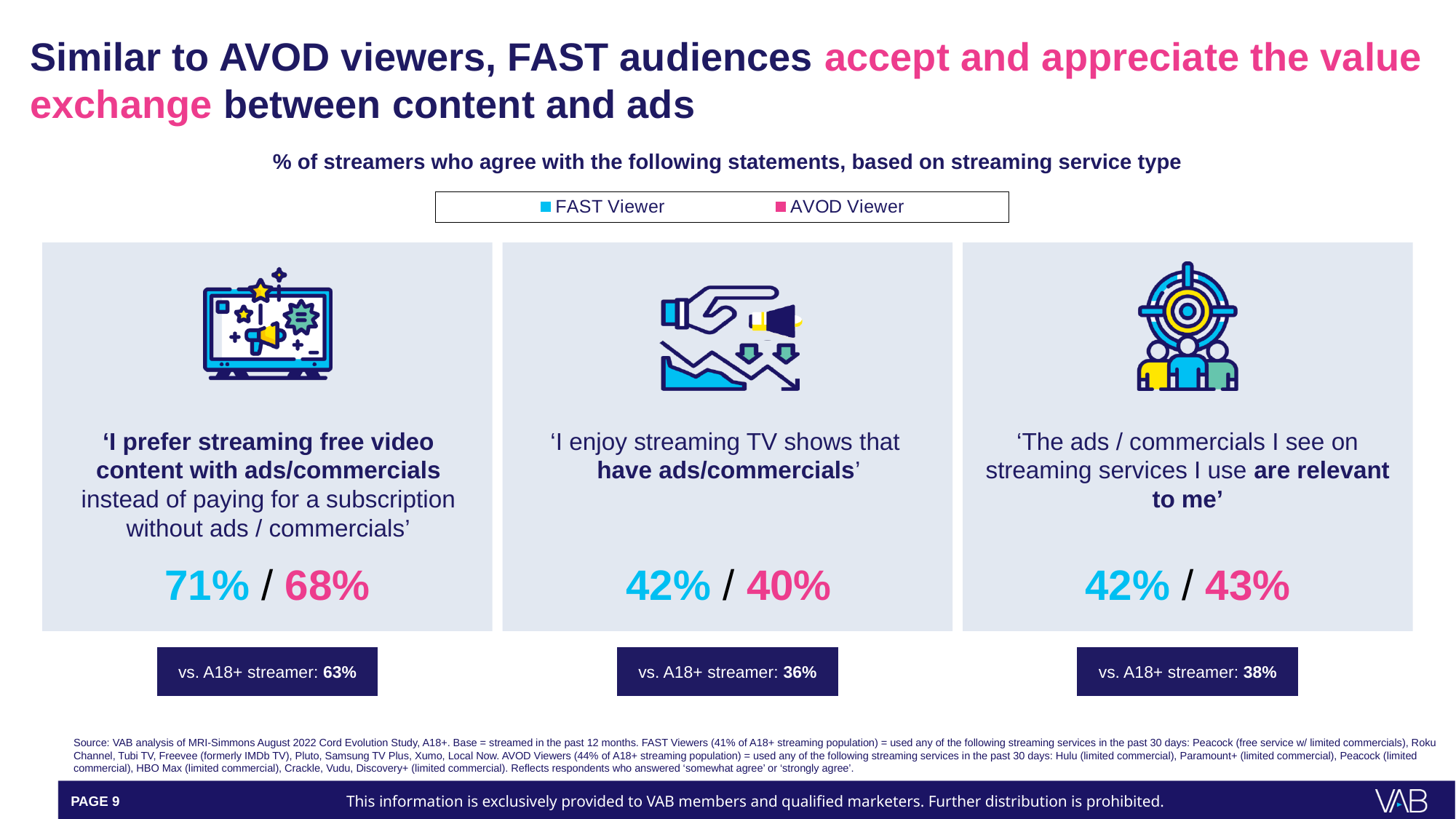
Which statement has the highest agreement among FAST Viewers? 'I prefer streaming free video content with ads/commercials instead of paying for a subscription without ads / commercials' How many viewer groups does the legend list? 2 For 'The ads / commercials I see on streaming services I use are relevant to me', which group has the higher agreement, FAST Viewers or AVOD Viewers? AVOD Viewers For 'I enjoy streaming TV shows that have ads/commercials', which group has the higher agreement, FAST Viewers or AVOD Viewers? FAST Viewers How many statements are shown on the slide? 3 What percentage of AVOD Viewers agree with 'I prefer streaming free video content with ads/commercials instead of paying for a subscription without ads / commercials'? 68% What is the A18+ streamer comparison value for 'I enjoy streaming TV shows that have ads/commercials'? 36% What percentage of FAST Viewers agree with 'I prefer streaming free video content with ads/commercials instead of paying for a subscription without ads / commercials'? 71% What is the difference between FAST Viewer and AVOD Viewer agreement for 'I prefer streaming free video content with ads/commercials instead of paying for a subscription without ads / commercials'? 3 percentage points What percentage of FAST Viewers agree with 'I enjoy streaming TV shows that have ads/commercials'? 42% Which colour represents AVOD Viewers in the legend? Pink What percentage of AVOD Viewers agree with 'The ads / commercials I see on streaming services I use are relevant to me'? 43%